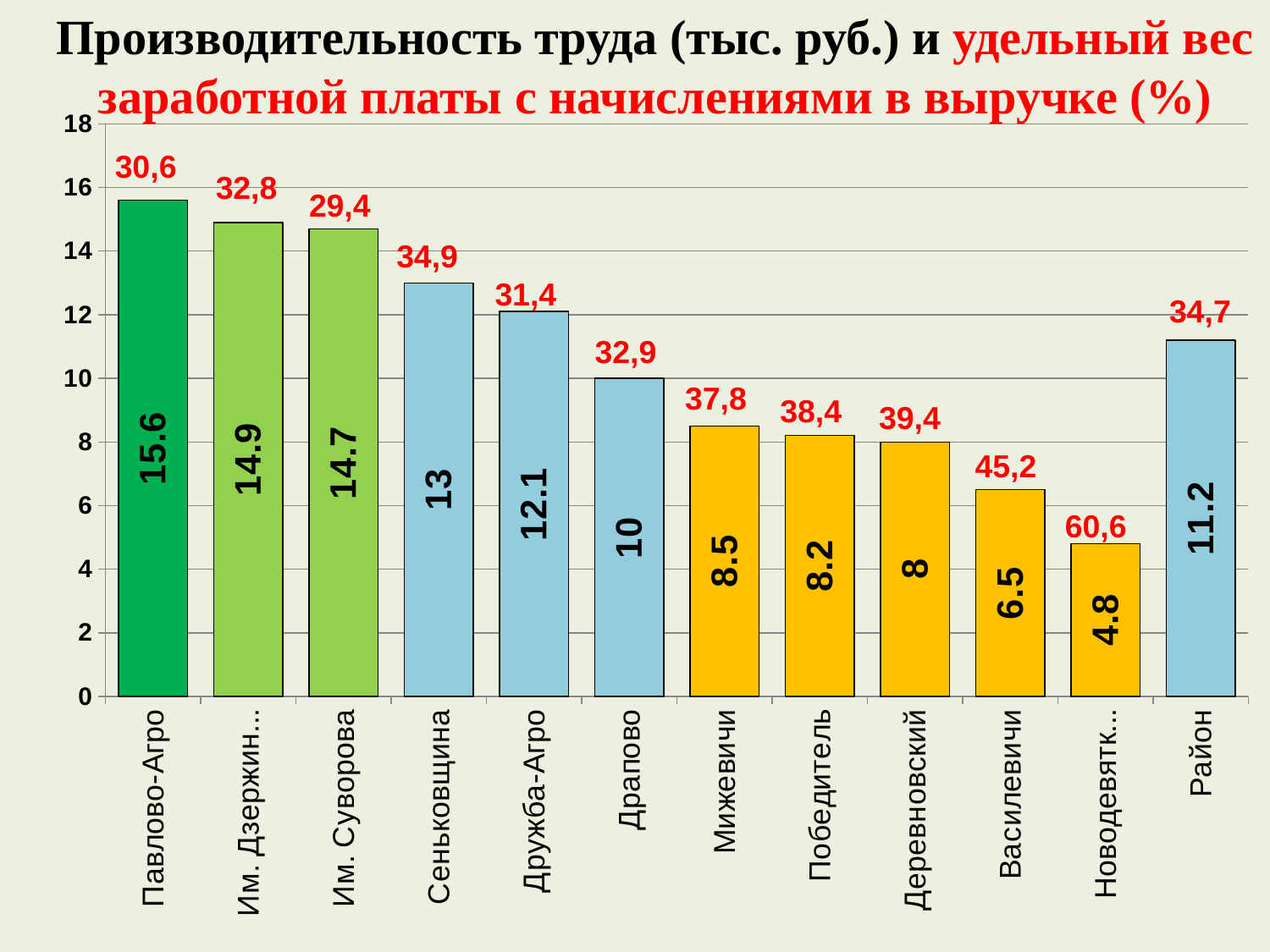
Which category has the tallest bar (highest labour productivity)? Павлово-Агро What is the red percentage label shown above the bar for Деревновский? 39,4 What is the difference between the bar values for Сеньковщина and Драпово? 3 What is the labour productivity value shown inside the bar for Павлово-Агро? 15.6 What kind of chart is shown on the slide? bar chart Is the bar value for Дружба-Агро greater or less than 12? greater Which category has the lowest red percentage label above its bar? Им. Суворова What is the labour productivity value shown inside the bar for Район? 11.2 What is the red percentage label shown above the bar for Василевичи? 45,2 Which has the larger bar value, Мижевичи or Победитель? Мижевичи How many categories are shown on the x axis? 12 Do the bar values rise or fall from Павлово-Агро to Василевичи along the x axis? fall